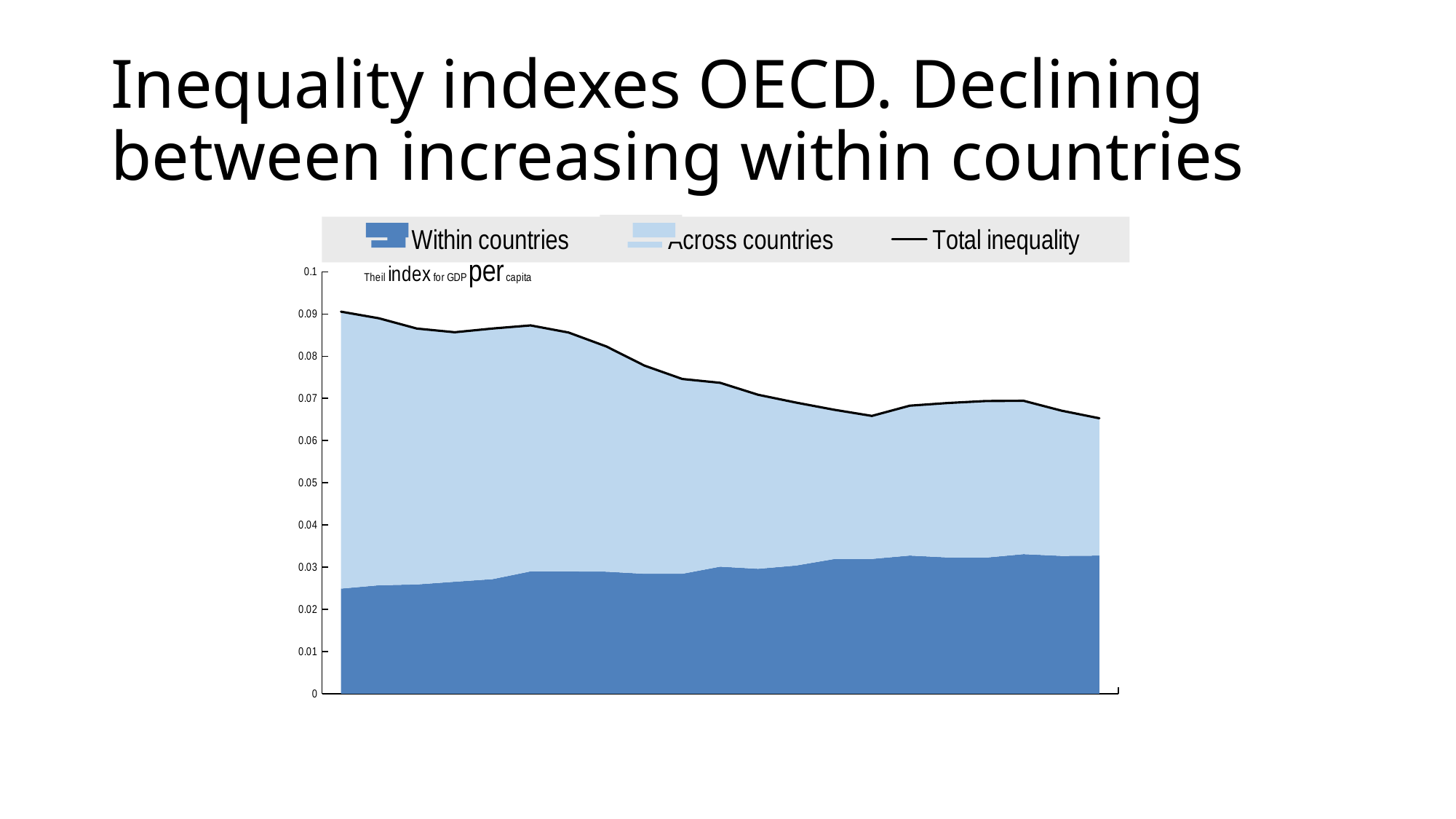
At the left end of the chart, which is larger: the Within countries component or the Across countries component? Across countries Is the Total inequality value at the right end of the chart greater or less than 0.07? less What kind of chart is shown on the slide? Stacked area chart How many series does the legend list? 3 Which series is drawn as a black line rather than a shaded area? Total inequality What is the highest value shown on the vertical axis? 0.1 Does the Within countries area rise or fall overall from left to right? Rise Is the Within countries value at the right end of the chart greater or less than 0.04? less Is the Within countries value at the left end of the chart greater or less than 0.02? greater Does the Total inequality line rise or fall overall from left to right? Fall